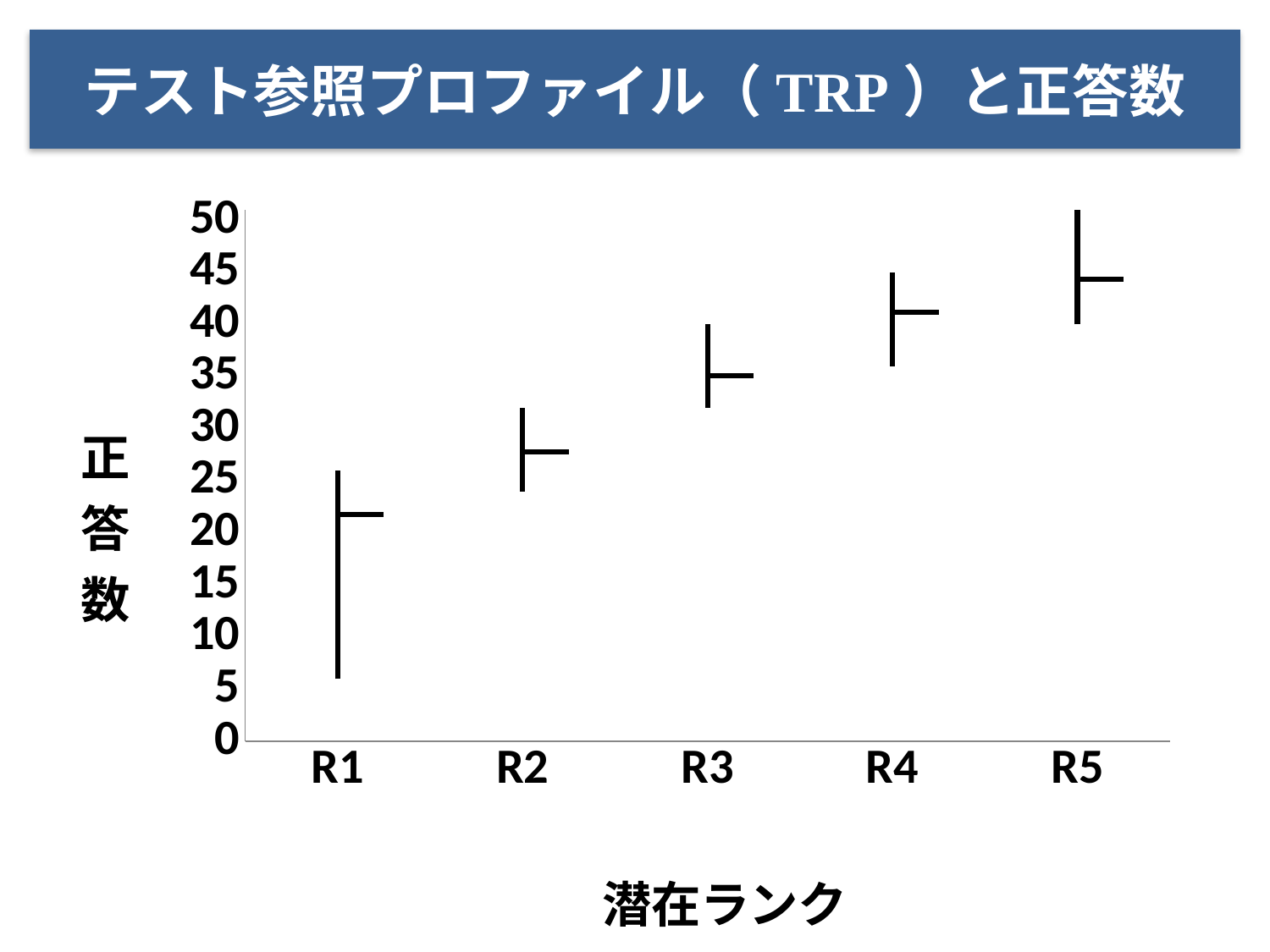
Is the marked value for R5 greater or less than 40? greater Is the marked value for R1 greater or less than 25? less Is the marked value for R2 greater or less than 30? less What is the label of the x axis? 潜在ランク Which category has the longest vertical range line in the chart? R1 What is the title of the slide? テスト参照プロファイル（TRP）と正答数 Which has the larger marked value, R2 or R4? R4 Which category has the highest marked value (horizontal tick) in the chart? R5 How many categories are shown on the x axis of the chart? 5 Do the marked values rise or fall from R1 to R5 along the x axis? rise Which category has the lowest marked value (horizontal tick) in the chart? R1